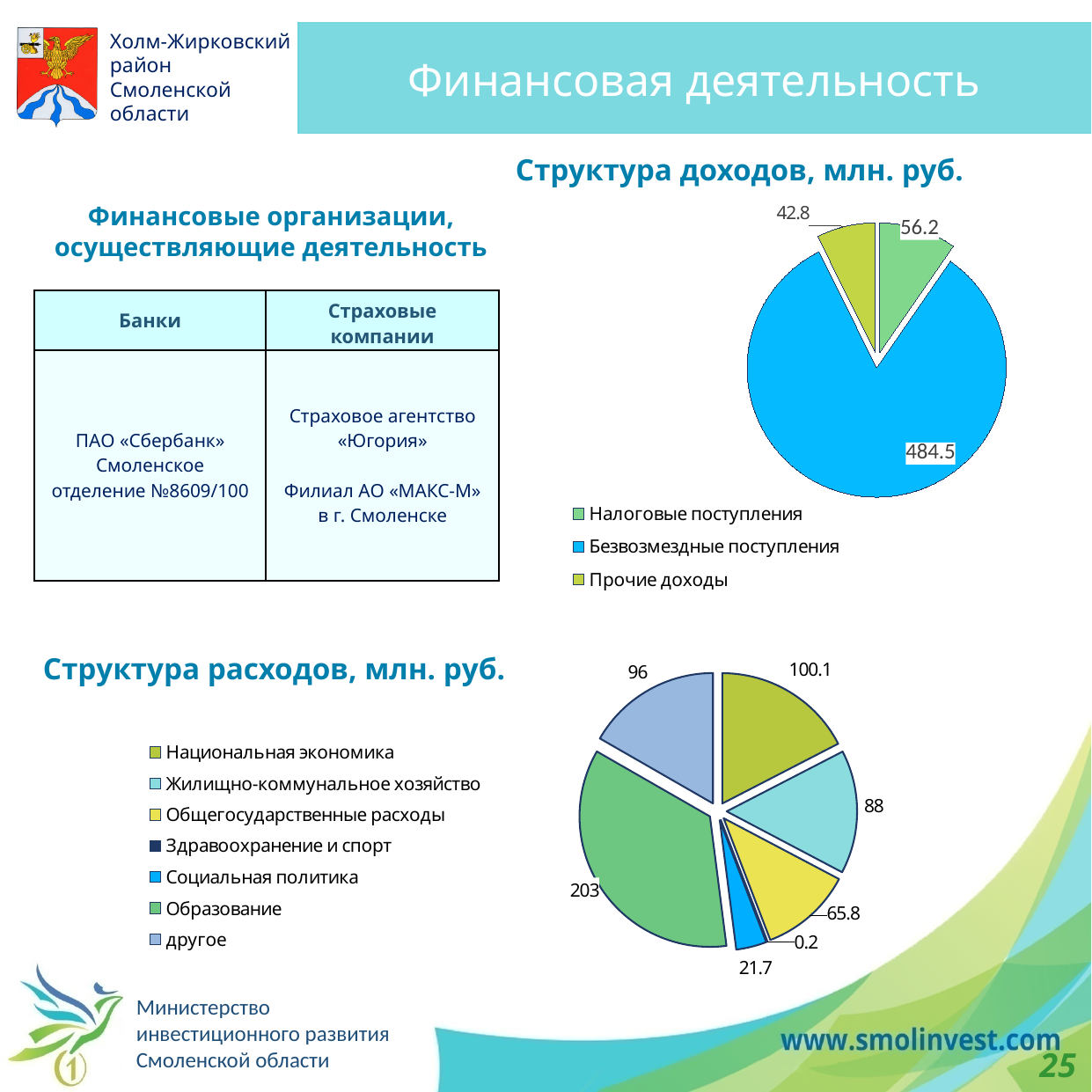
What type of chart is used for 'Структура доходов, млн. руб.'? Pie chart In the chart 'Структура расходов, млн. руб.', which category has the smallest value? Здравоохранение и спорт In the chart 'Структура расходов, млн. руб.', what is the difference between Образование and другое? 107 In the chart 'Структура расходов, млн. руб.', how many categories does the legend list? 7 In the chart 'Структура доходов, млн. руб.', what is the value for Прочие доходы? 42.8 In the chart 'Структура доходов, млн. руб.', which category has the largest value? Безвозмездные поступления In the chart 'Структура расходов, млн. руб.', what is the value for Образование? 203 In the chart 'Структура расходов, млн. руб.', which is larger: Национальная экономика or Жилищно-коммунальное хозяйство? Национальная экономика In the chart 'Структура расходов, млн. руб.', what is the value for Социальная политика? 21.7 In the chart 'Структура доходов, млн. руб.', what is the difference between Налоговые поступления and Прочие доходы? 13.4 In the chart 'Структура доходов, млн. руб.', what is the value for Безвозмездные поступления? 484.5 In the chart 'Структура доходов, млн. руб.', how many categories does the legend list? 3